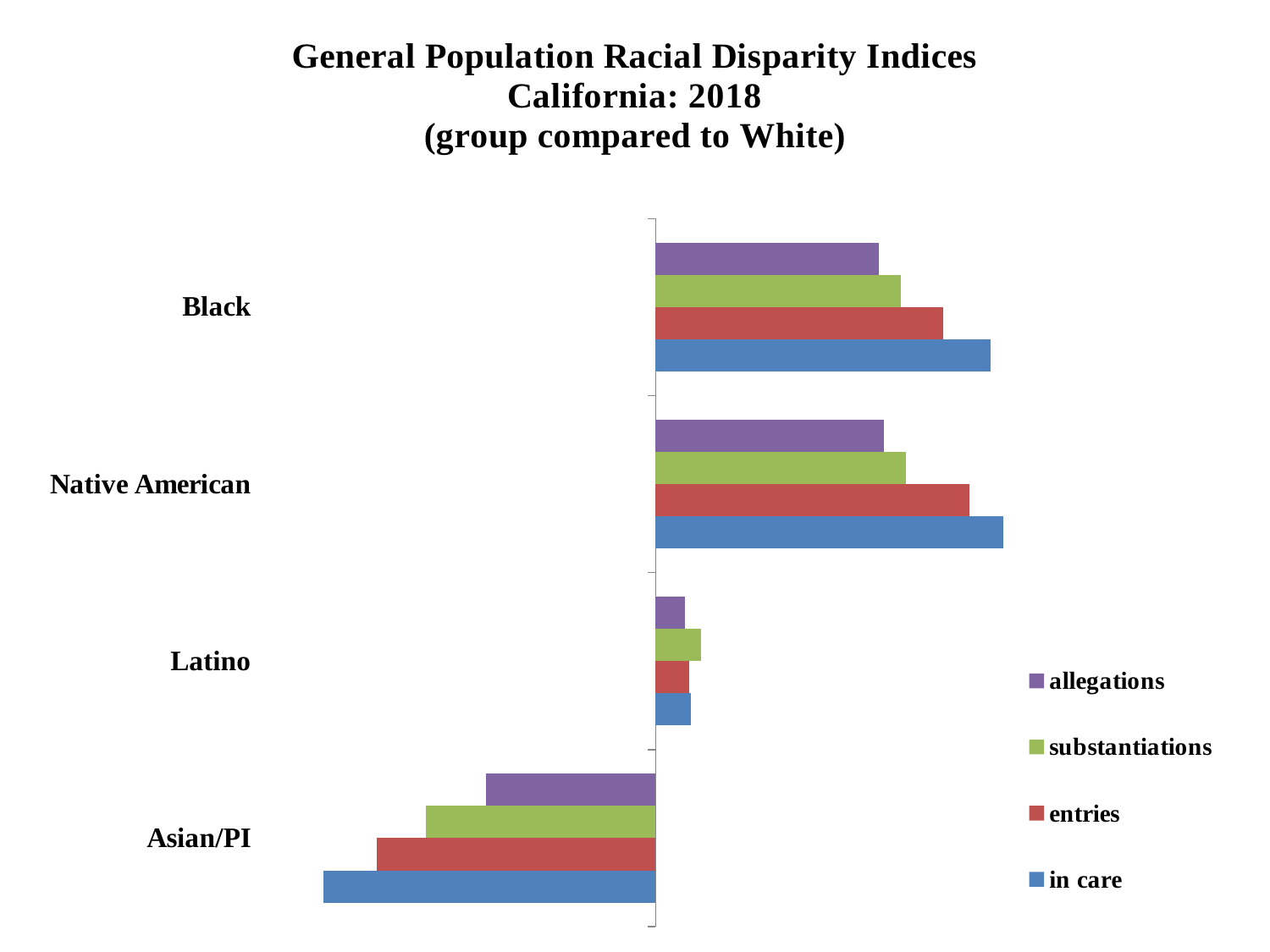
Which group has the shortest bars overall among those extending to the right of the axis? Latino For the Native American group, which is larger: the entries bar or the substantiations bar? entries How many racial groups are plotted on the chart? 4 For the Black group, which is larger: the allegations bar or the in care bar? in care How many series does the legend list? 4 For the Black group, which series has the shortest bar? allegations What kind of chart is shown on the slide? bar chart Which group is the only one whose bars extend to the left of the axis (negative values)? Asian/PI Which series is shown in blue in the legend? in care For the Black group, which series has the longest bar? in care For the Latino group, which series has the longest bar? substantiations For the Asian/PI group, which series extends furthest to the left? in care